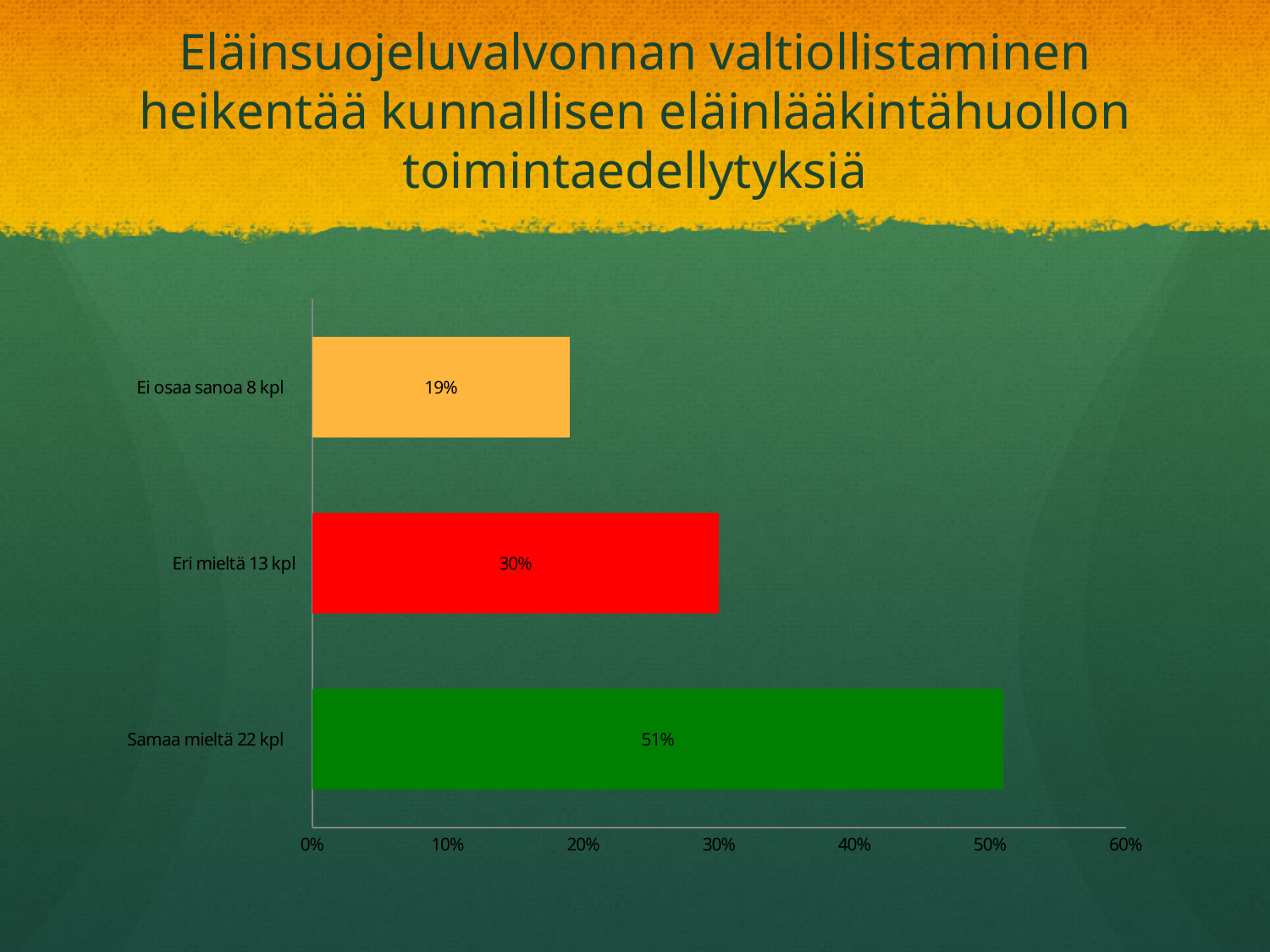
What is the difference between the values for "Eri mieltä 13 kpl" and "Ei osaa sanoa 8 kpl"? 11% What kind of chart is shown on the slide? Bar chart What is the value for "Eri mieltä 13 kpl"? 30% What is the value for "Samaa mieltä 22 kpl"? 51% Which category has the highest value? Samaa mieltä 22 kpl Which category has the lowest value? Ei osaa sanoa 8 kpl Which is larger, the value for "Eri mieltä 13 kpl" or the value for "Ei osaa sanoa 8 kpl"? Eri mieltä 13 kpl What colour is the bar for "Samaa mieltä 22 kpl"? Green Is the value for "Samaa mieltä 22 kpl" greater or less than 40%? greater What is the value for "Ei osaa sanoa 8 kpl"? 19% How many categories are shown in the chart? 3 What is the difference between the values for "Samaa mieltä 22 kpl" and "Eri mieltä 13 kpl"? 21%